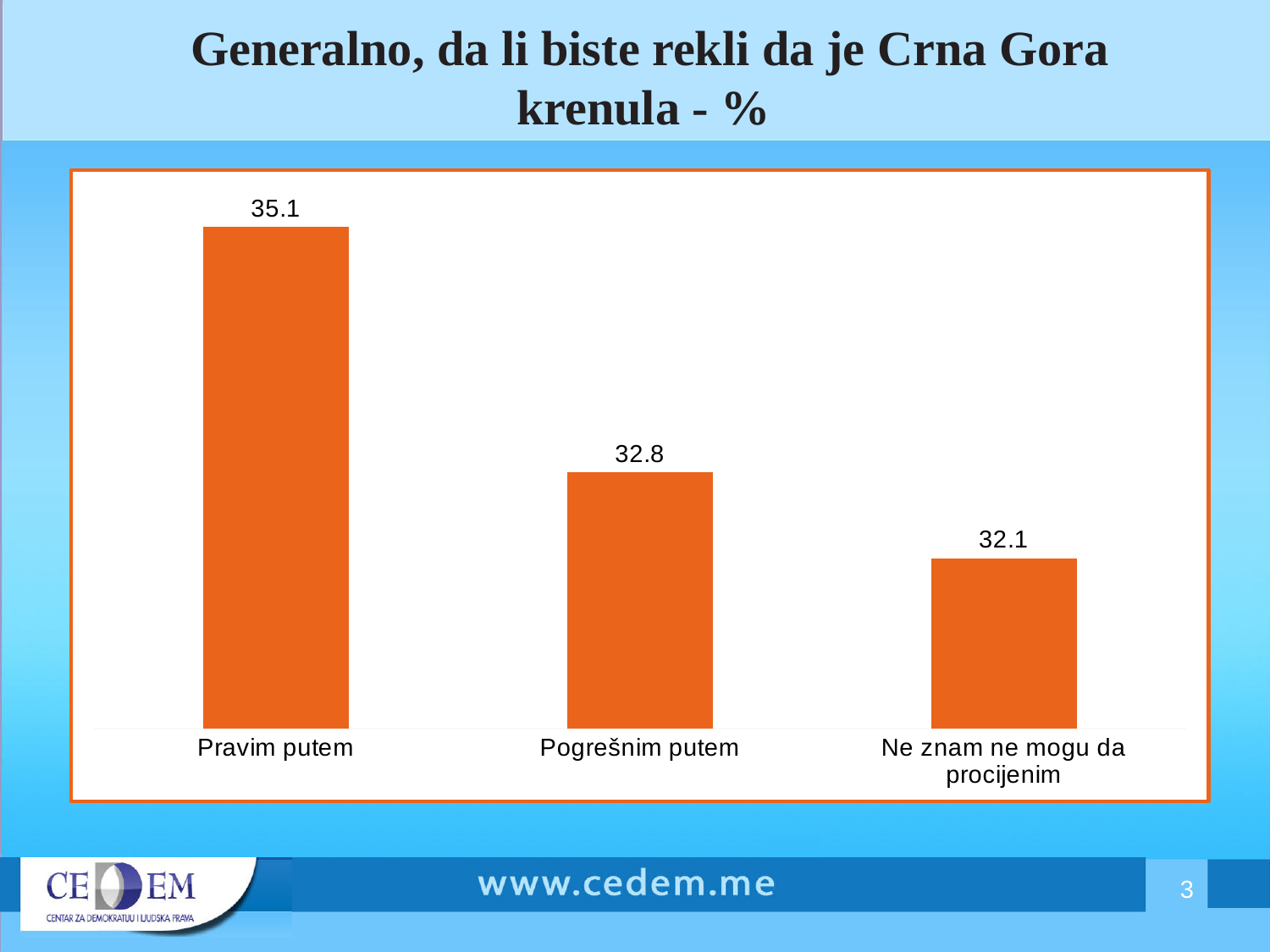
What is the title of the chart? Generalno, da li biste rekli da je Crna Gora krenula - % What is the value for "Pravim putem"? 35.1 What kind of chart is shown on the slide? Bar chart What is the difference between the values for "Pravim putem" and "Pogrešnim putem"? 2.3 What is the value for "Pogrešnim putem"? 32.8 Which category has the highest value? Pravim putem Do the values rise or fall from left to right across the categories? Fall How many categories are shown in the chart? 3 What is the difference between the values for "Pogrešnim putem" and "Ne znam ne mogu da procijenim"? 0.7 What is the value for "Ne znam ne mogu da procijenim"? 32.1 Which is larger, the value for "Pravim putem" or the value for "Ne znam ne mogu da procijenim"? Pravim putem Which category has the lowest value? Ne znam ne mogu da procijenim